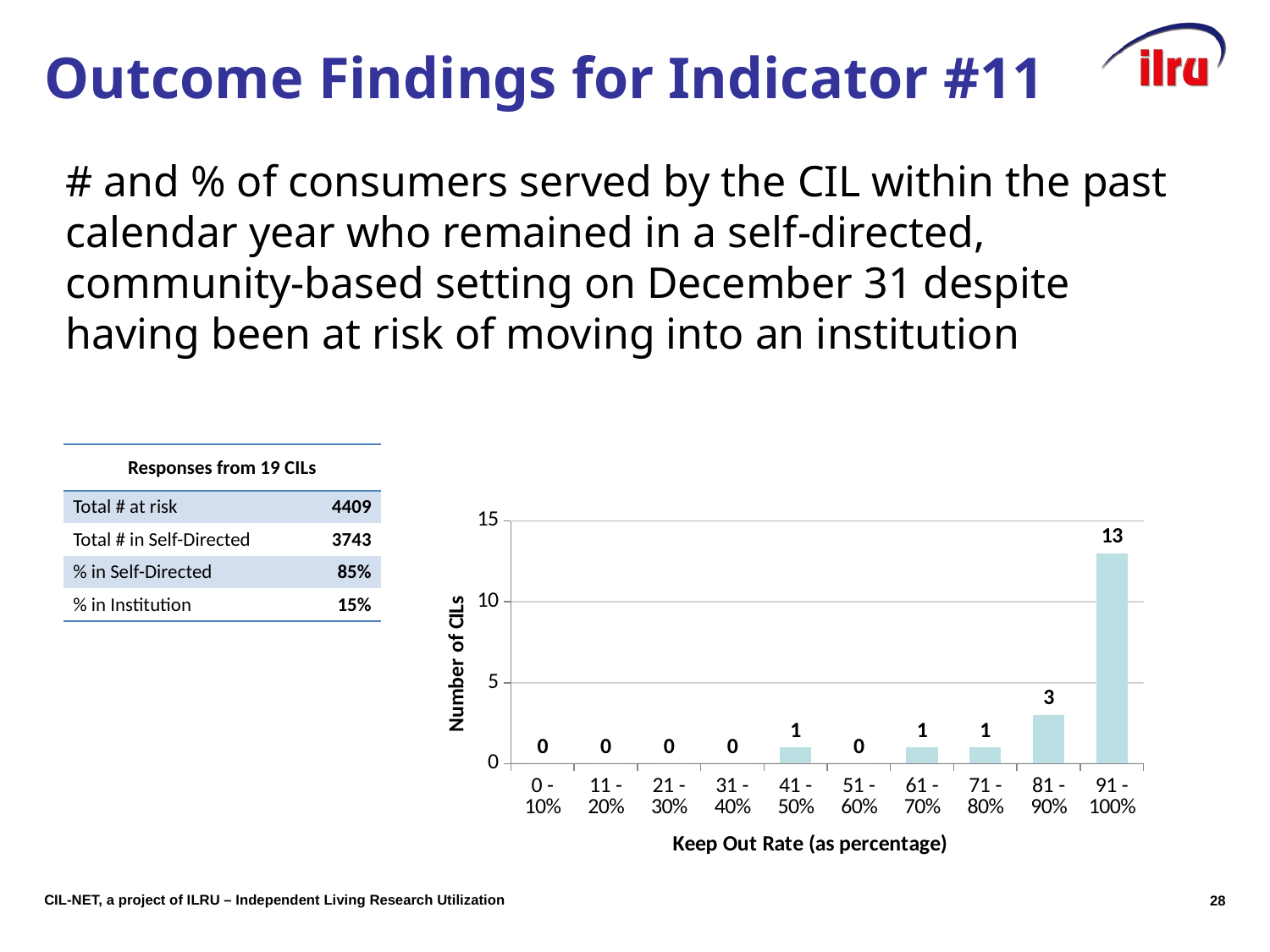
What is the number of CILs for the 41 - 50% keep out rate bin? 1 How many keep out rate bins are shown on the x axis? 10 Is the number of CILs for the 91 - 100% bin greater or less than 10? greater What type of chart is shown on the slide? bar chart What is the label of the x axis of the chart? Keep Out Rate (as percentage) What is the label of the y axis of the chart? Number of CILs What is the difference in number of CILs between the 91 - 100% bin and the 81 - 90% bin? 10 Which keep out rate bin has the highest number of CILs? 91 - 100% What is the number of CILs for the 51 - 60% keep out rate bin? 0 What is the number of CILs for the 91 - 100% keep out rate bin? 13 What is the number of CILs for the 81 - 90% keep out rate bin? 3 Which has more CILs, the 81 - 90% bin or the 71 - 80% bin? 81 - 90%